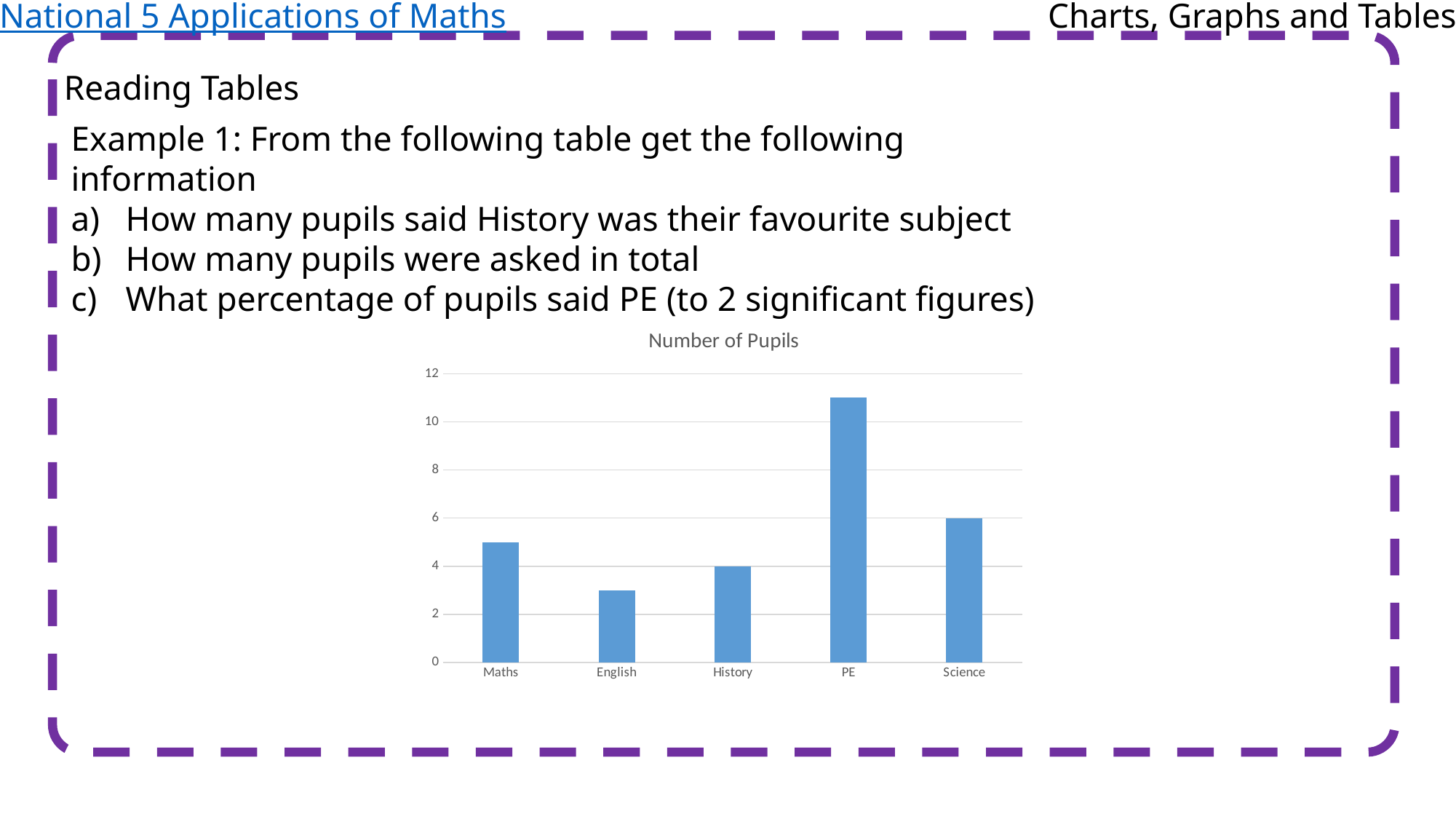
What type of chart is shown on the slide? bar chart Which has more pupils, Science or History? Science Which subject has the highest number of pupils? PE What is the number of pupils for History? 4 How many subjects are shown on the x axis of the chart? 5 What is the title of the chart? Number of Pupils Which subject has the lowest number of pupils? English Is the value for PE greater or less than 10? greater Is the value for Maths greater or less than 4? greater What is the difference between the number of pupils for Science and for History? 2 Is the value for English greater or less than 4? less What is the number of pupils for Science? 6